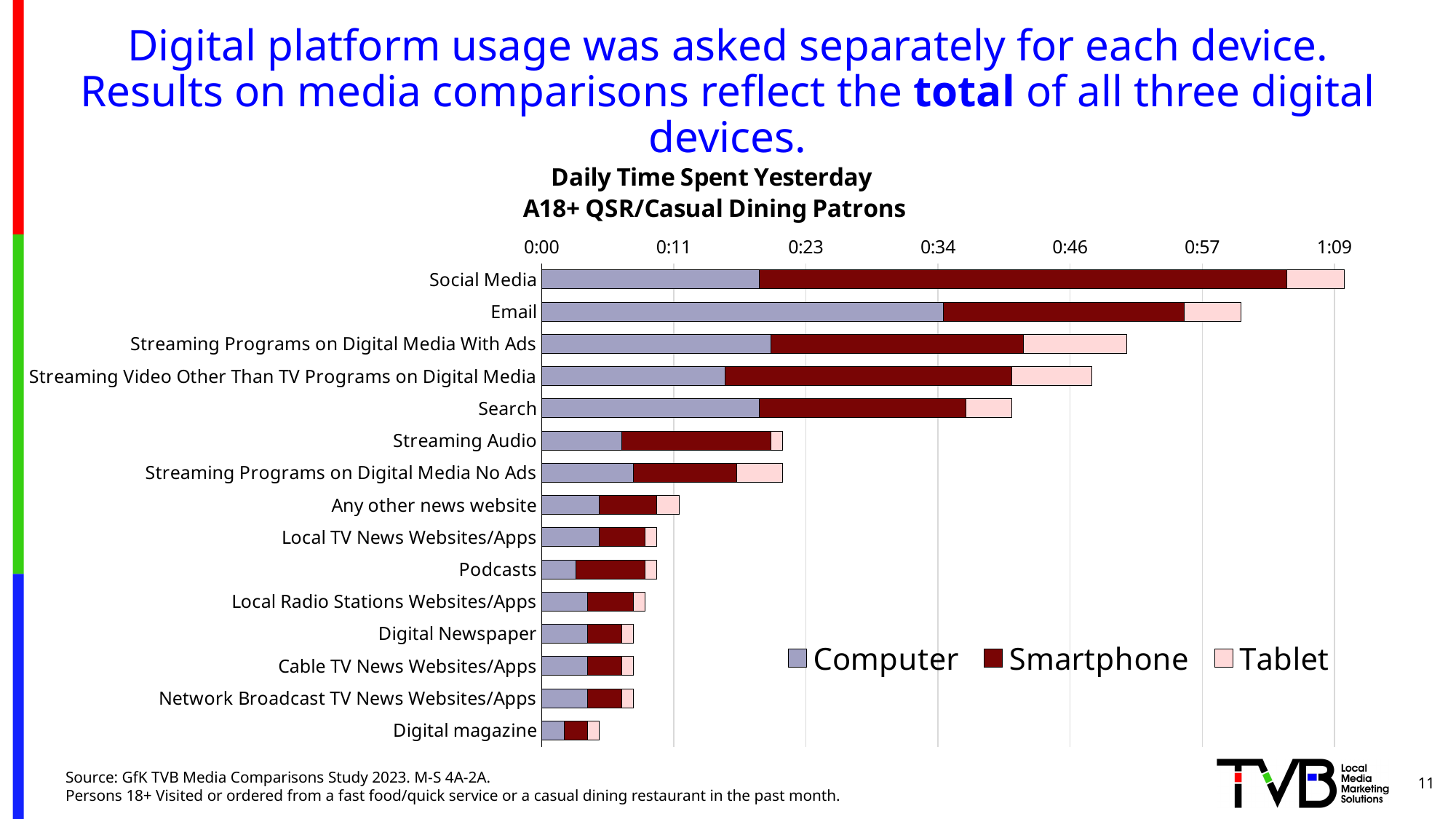
Is the total bar for Social Media greater or less than 0:57? greater Which category has the longest total bar? Social Media Is the total bar for Digital magazine greater or less than 0:11? less Is the total bar for Streaming Audio greater or less than 0:23? less Which has the longer Computer segment, Email or Social Media? Email Which category has the shortest total bar? Digital magazine How many categories are plotted on the chart? 15 Which series is shown in dark red in the legend? Smartphone What kind of chart is shown on the slide? Stacked bar chart How many series does the legend list? 3 Which has the longer total bar, Social Media or Email? Social Media